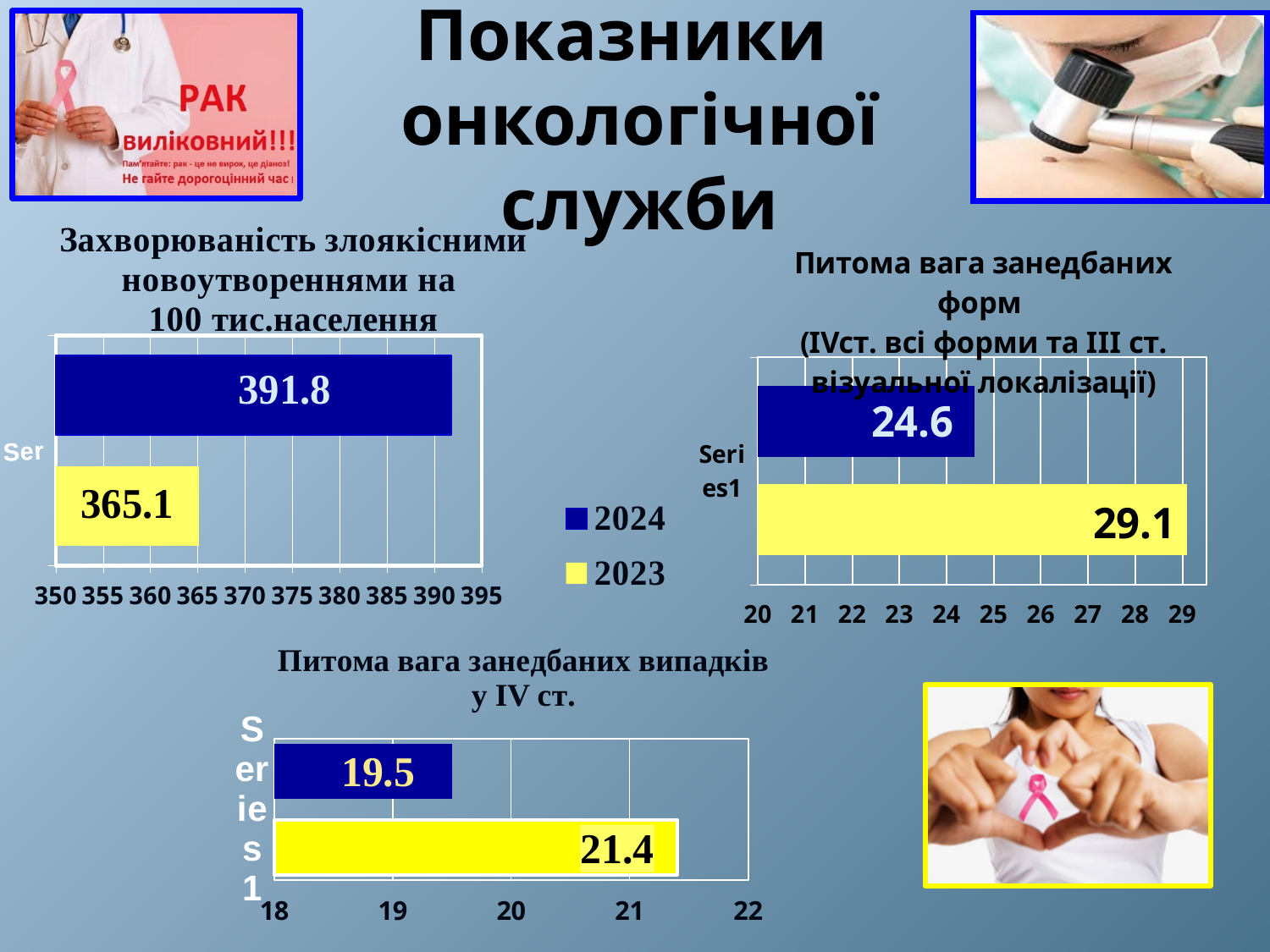
In the chart titled 'Питома вага занедбаних випадків у IV ст.', what is the value of the yellow (2023) bar? 21.4 In the chart titled 'Питома вага занедбаних форм', what is the difference between the 2023 and 2024 values? 4.5 How many entries does the legend in the middle of the slide list? 2 In the chart titled 'Питома вага занедбаних форм', which bar is larger, the blue (2024) or the yellow (2023)? yellow (2023) In the chart titled 'Питома вага занедбаних випадків у IV ст.', what is the value of the blue (2024) bar? 19.5 In the chart titled 'Питома вага занедбаних форм', what is the value of the yellow (2023) bar? 29.1 In the chart titled 'Питома вага занедбаних форм', what is the value of the blue (2024) bar? 24.6 In the chart titled 'Захворюваність злоякісними новоутвореннями на 100 тис.населення', what is the value of the yellow (2023) bar? 365.1 In the chart titled 'Захворюваність злоякісними новоутвореннями на 100 тис.населення', what is the value of the blue (2024) bar? 391.8 In the chart titled 'Питома вага занедбаних випадків у IV ст.', what is the difference between the 2023 and 2024 values? 1.9 In the chart titled 'Захворюваність злоякісними новоутвореннями на 100 тис.населення', what is the difference between the 2024 and 2023 values? 26.7 What kind of chart is the one titled 'Захворюваність злоякісними новоутвореннями на 100 тис.населення'? bar chart